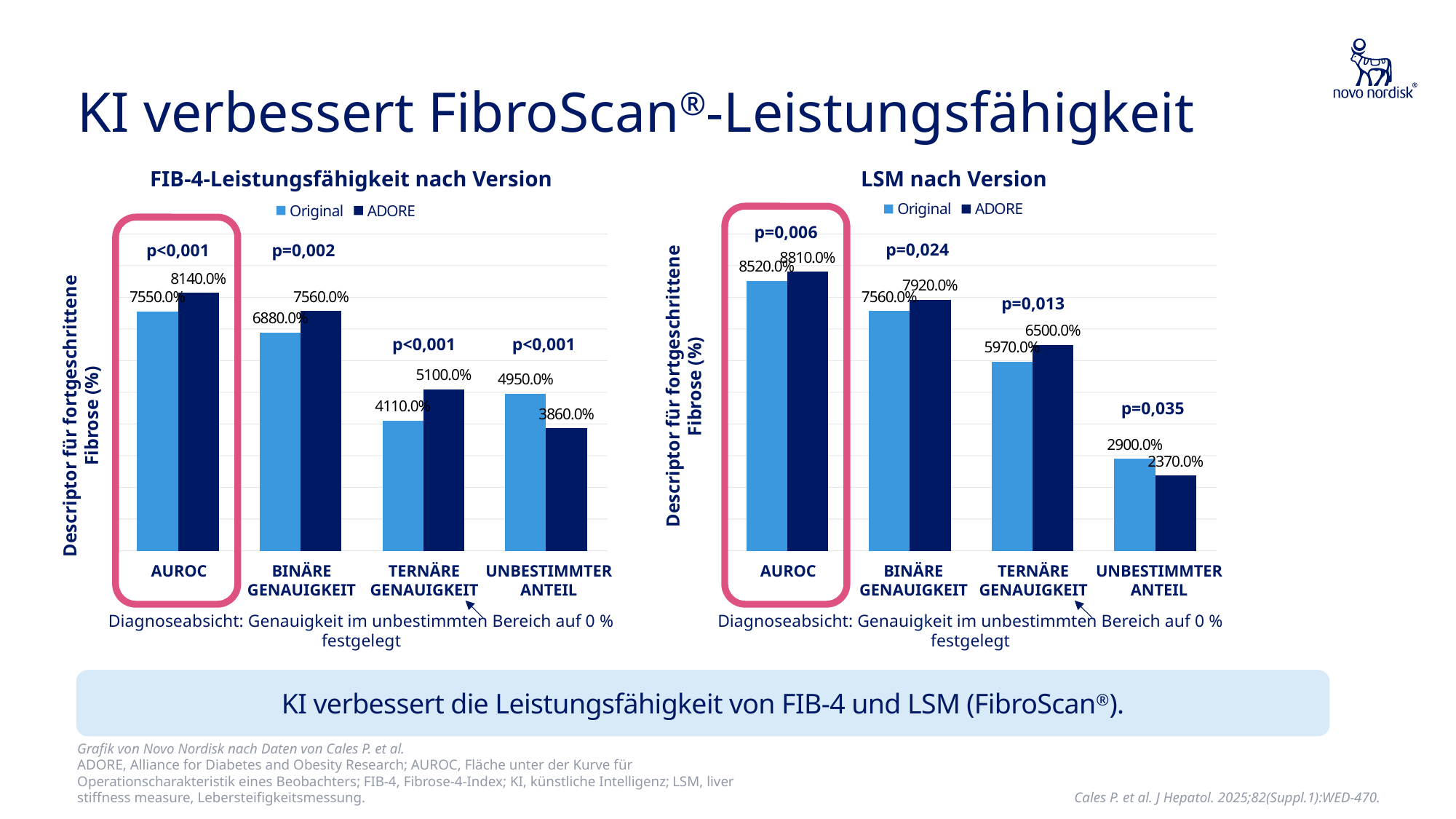
In the chart 'LSM nach Version', what is the difference between the Original and ADORE values for UNBESTIMMTER ANTEIL? 530.0% In the chart 'FIB-4-Leistungsfähigkeit nach Version', which category has the lowest Original value? TERNÄRE GENAUIGKEIT How many categories are shown on the x axis of the chart 'LSM nach Version'? 4 In the chart 'LSM nach Version', what is the Original value for AUROC? 8520.0% In the chart 'FIB-4-Leistungsfähigkeit nach Version', for UNBESTIMMTER ANTEIL, which is larger: Original or ADORE? Original In the chart 'LSM nach Version', what is the ADORE value for UNBESTIMMTER ANTEIL? 2370.0% How many series does the legend of the chart 'FIB-4-Leistungsfähigkeit nach Version' list? 2 What type of chart is 'LSM nach Version'? Bar chart In the chart 'FIB-4-Leistungsfähigkeit nach Version', what is the Original value for TERNÄRE GENAUIGKEIT? 4110.0% In the chart 'FIB-4-Leistungsfähigkeit nach Version', what is the difference between the ADORE and Original values for AUROC? 590.0% In the chart 'LSM nach Version', which category has the highest ADORE value? AUROC In the chart 'FIB-4-Leistungsfähigkeit nach Version', what is the value for ADORE at AUROC? 8140.0%